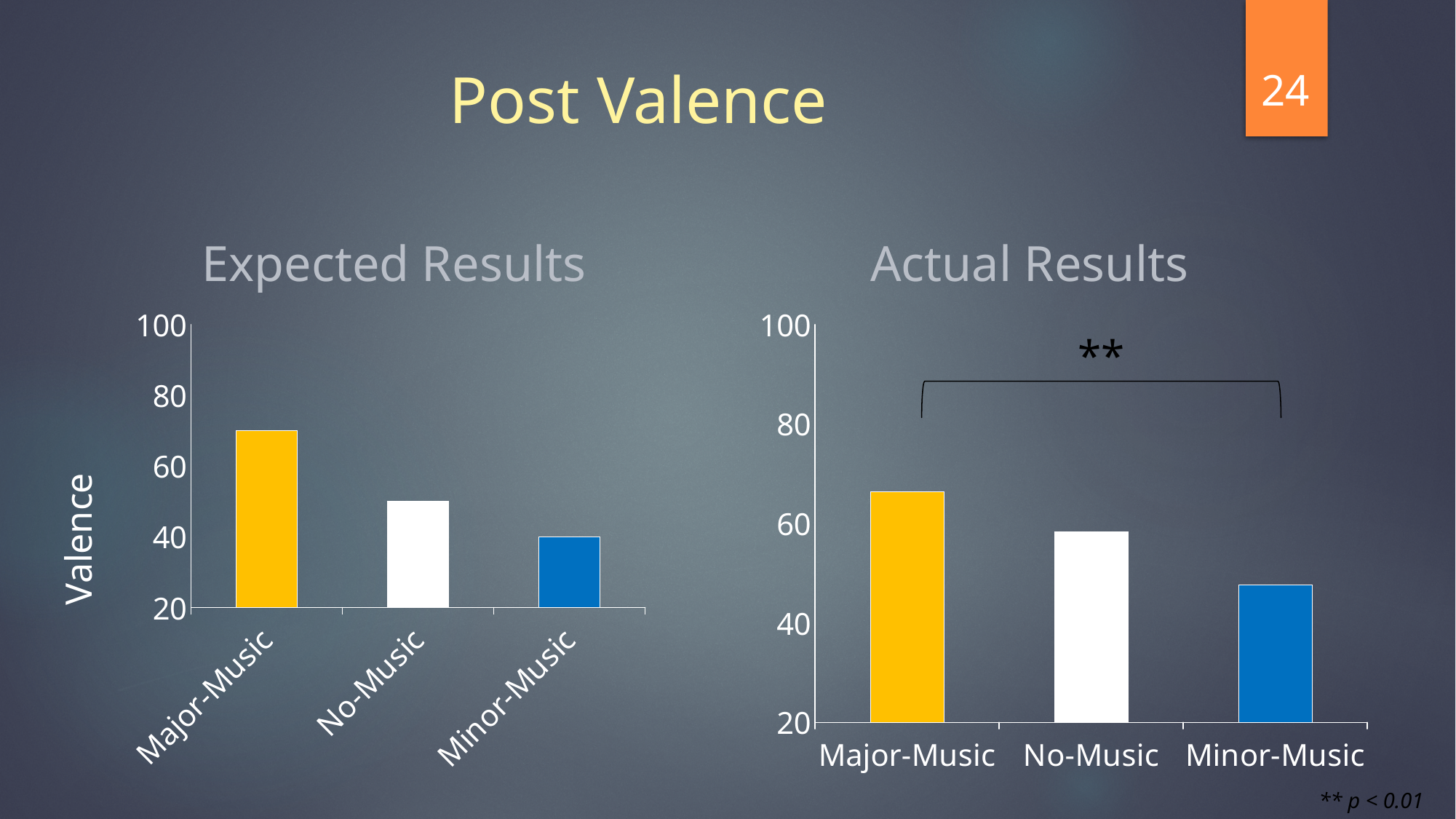
In the Expected Results chart, is the value for No-Music greater or less than 60? less How many categories are shown in the Expected Results chart? 3 In the Actual Results chart, which category has the lowest value? Minor-Music In the Expected Results chart, which category has the lowest value? Minor-Music What is the label on the vertical axis of the Expected Results chart? Valence In the Expected Results chart, is the value for Major-Music greater or less than 60? greater In the Actual Results chart, do the values rise or fall from Major-Music to Minor-Music? fall In the Expected Results chart, which category has the highest value? Major-Music In the Actual Results chart, which category has the highest value? Major-Music In the Actual Results chart, is the value for Minor-Music greater or less than 60? less What kind of chart is the Expected Results chart? bar chart In the Actual Results chart, which is larger, the value for No-Music or the value for Minor-Music? No-Music